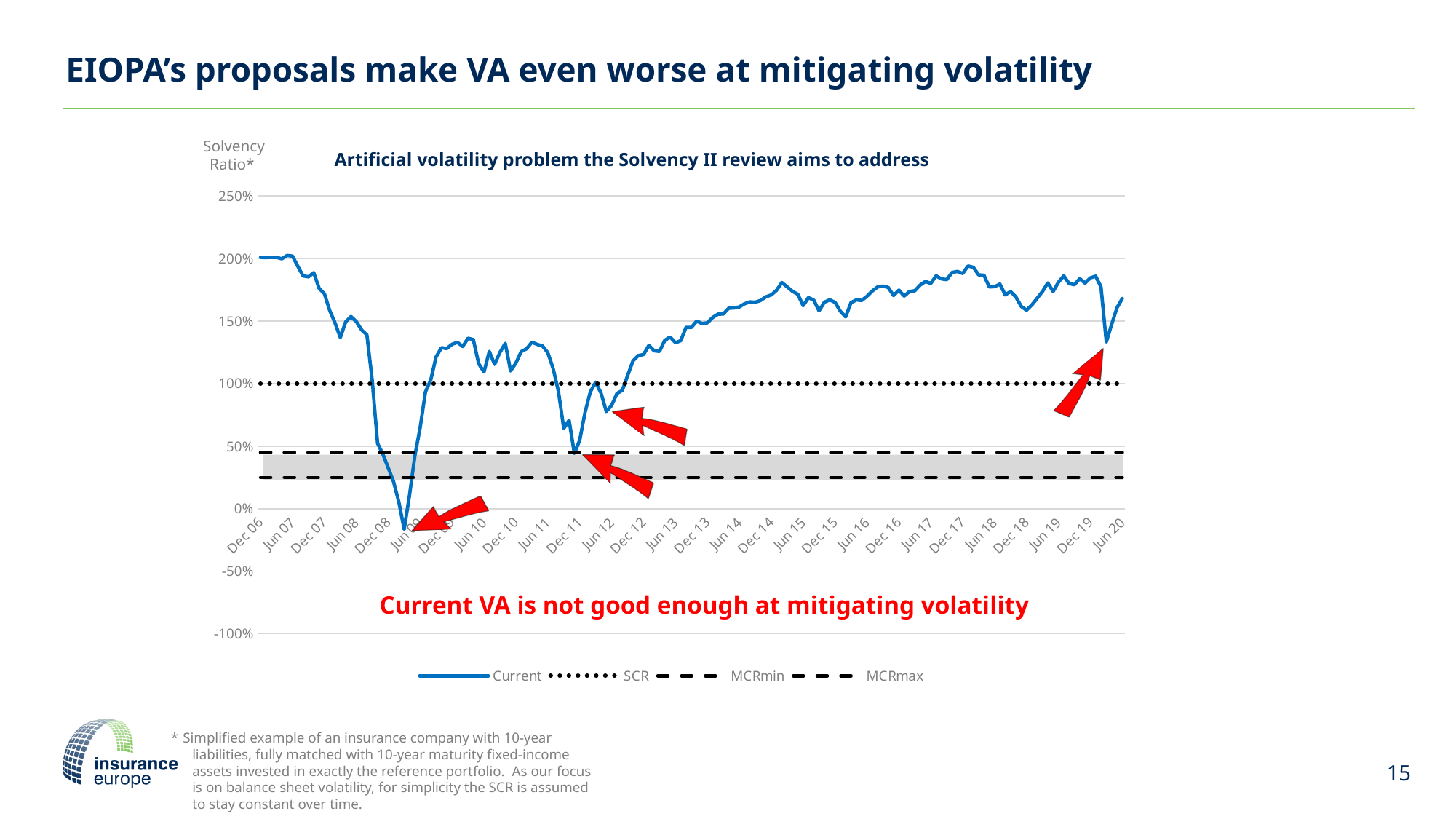
Is the value of the Current series at Dec 11 greater or less than 100%? less At what level does the dotted SCR line sit on the y axis? 100% What is the title of the chart? Artificial volatility problem the Solvency II review aims to address Around which date does the Current series reach its lowest point? Jun 09 Is the value of the Current series at Jun 20 greater or less than 150%? greater Does the Current series rise or fall between Jun 12 and Dec 14? rise How many series does the legend list? 4 Which is larger for the Current series: the value at Dec 06 or the value at Jun 09? Dec 06 Is the value of the Current series at Dec 06 greater or less than 150%? greater Which series are listed in the chart legend? Current, SCR, MCRmin, MCRmax What kind of chart is shown on the slide? line chart